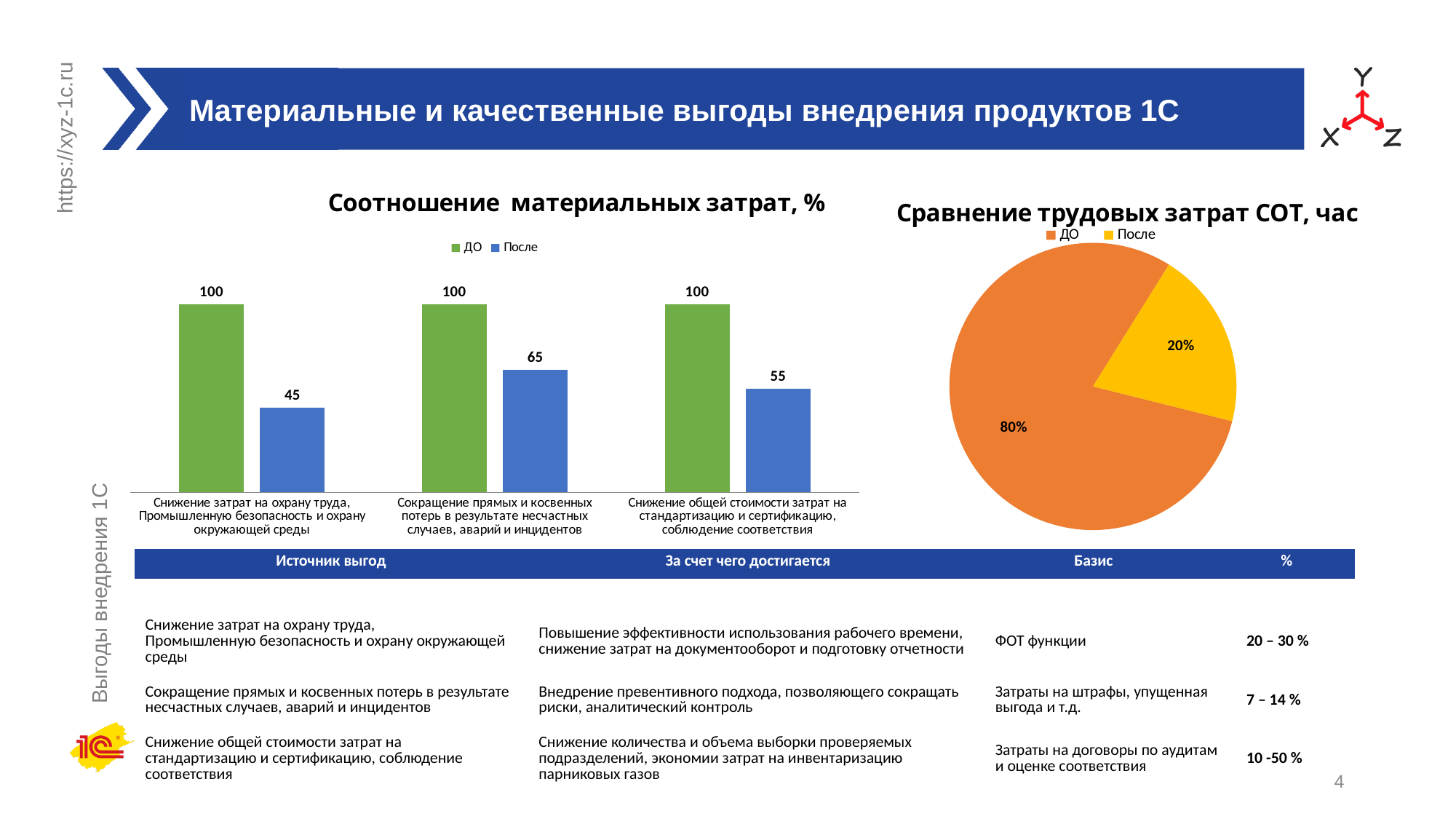
In the chart 'Соотношение материальных затрат, %', which category has the lowest 'После' value? Снижение затрат на охрану труда, Промышленную безопасность и охрану окружающей среды In the chart 'Соотношение материальных затрат, %', how many categories are shown on the x axis? 3 In the pie chart 'Сравнение трудовых затрат СОТ, час', which slice is larger, 'ДО' or 'После'? ДО In the chart 'Соотношение материальных затрат, %', which category has the highest 'После' value? Сокращение прямых и косвенных потерь в результате несчастных случаев, аварий и инцидентов In the chart 'Соотношение материальных затрат, %', how many series does the legend list? 2 What kind of chart is 'Сравнение трудовых затрат СОТ, час'? pie chart In the chart 'Соотношение материальных затрат, %', what is the difference between the 'ДО' and 'После' values for 'Сокращение прямых и косвенных потерь в результате несчастных случаев, аварий и инцидентов'? 35 In the chart 'Соотношение материальных затрат, %', what is the value of 'ДО' for 'Снижение общей стоимости затрат на стандартизацию и сертификацию, соблюдение соответствия'? 100 In the chart 'Соотношение материальных затрат, %', what is the value of 'После' for 'Снижение затрат на охрану труда, Промышленную безопасность и охрану окружающей среды'? 45 In the pie chart 'Сравнение трудовых затрат СОТ, час', what share does 'ДО' have? 80% In the chart 'Соотношение материальных затрат, %', what is the value of 'После' for 'Снижение общей стоимости затрат на стандартизацию и сертификацию, соблюдение соответствия'? 55 In the chart 'Соотношение материальных затрат, %', what is the value of 'После' for 'Сокращение прямых и косвенных потерь в результате несчастных случаев, аварий и инцидентов'? 65